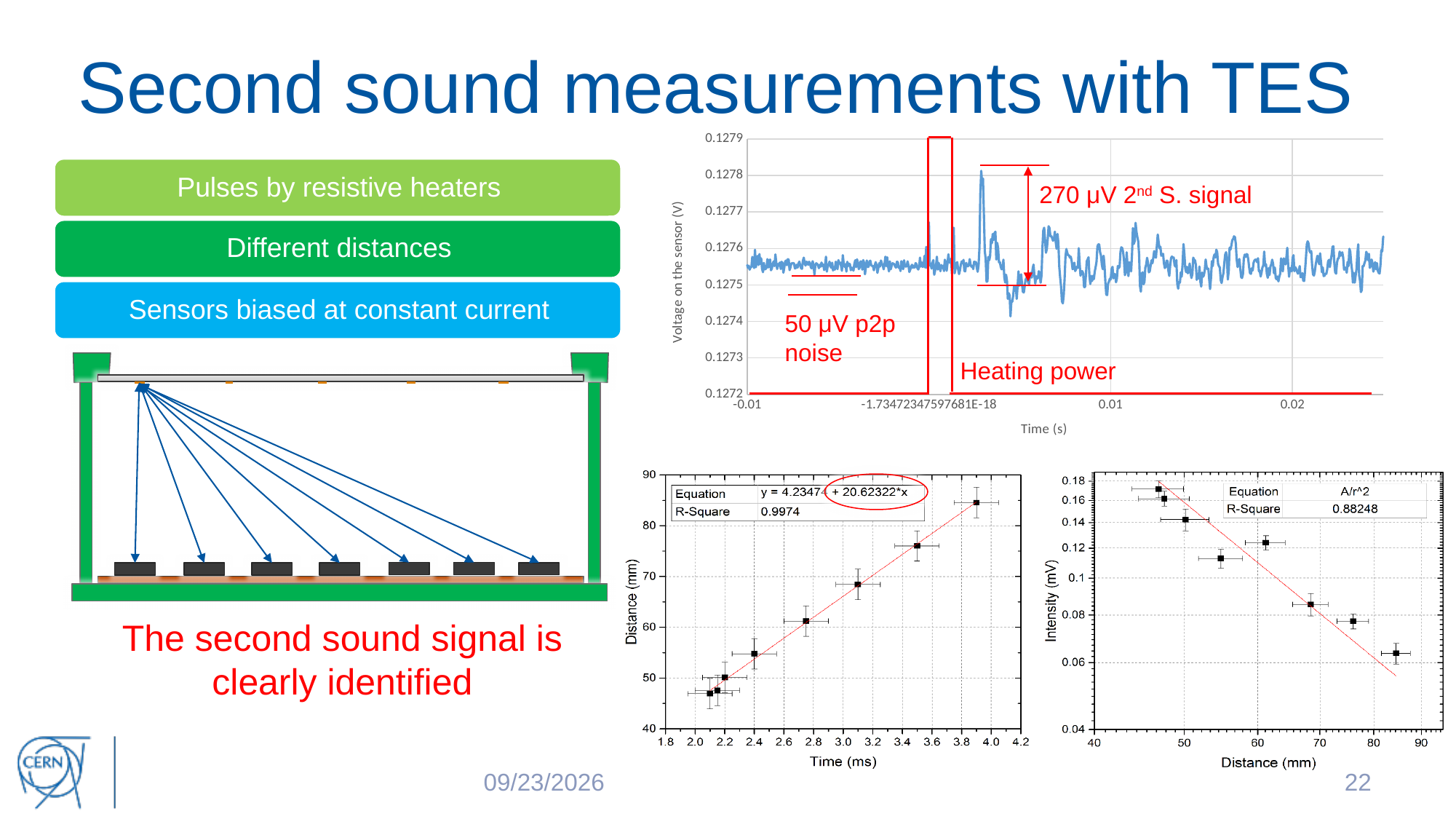
In the bottom-right chart of intensity versus distance, is the intensity for the point at about 85 mm greater or less than 0.08 mV? less In the bottom-right chart of intensity versus distance, how many data points are plotted? 8 In the bottom-middle chart of distance versus time, what fitted equation is shown? y = 4.2347 + 20.62322*x In the top-right chart, what amplitude is annotated for the second sound signal? 270 µV In the bottom-middle chart of distance versus time, do the distance values rise or fall as time increases? rise What kind of chart is the top-right chart of voltage on the sensor versus time? line chart In the top-right chart, what peak-to-peak noise level is annotated? 50 µV p2p noise In the bottom-right chart of intensity versus distance, do the intensity values rise or fall as distance increases? fall In the bottom-right chart of intensity versus distance, what R-Square value is shown? 0.88248 What is the label of the y-axis of the top-right chart? Voltage on the sensor (V) In the bottom-middle chart of distance versus time, what R-Square value is shown? 0.9974 In the bottom-middle chart of distance versus time, is the distance for the point at about 3.9 ms greater or less than 80 mm? greater